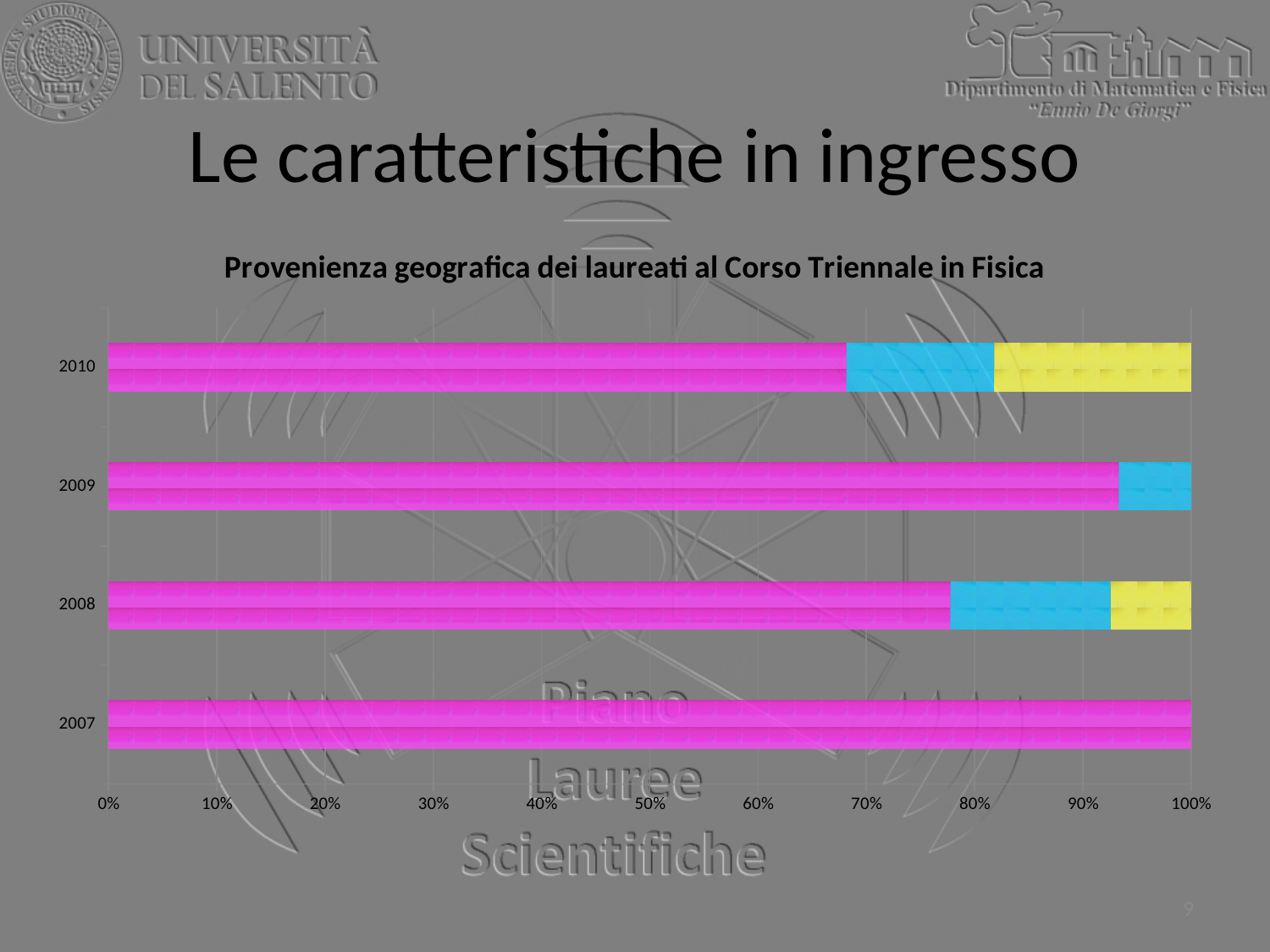
What is the maximum value shown on the horizontal axis? 100% Which year has a bar made up entirely of the magenta segment? 2007 What kind of chart is shown on the slide? bar chart What is the title of the chart? Provenienza geografica dei laureati al Corso Triennale in Fisica Is the magenta segment for 2008 greater or less than 70%? greater Which year has the larger yellow segment, 2010 or 2008? 2010 Which year has the larger magenta segment, 2009 or 2008? 2009 Is the magenta segment for 2010 greater or less than 70%? less Is the magenta segment for 2009 greater or less than 90%? greater How many differently coloured segments (series) appear in the bars of the chart? 3 Which year has the smallest magenta segment? 2010 How many years (categories) are shown on the vertical axis of the chart? 4